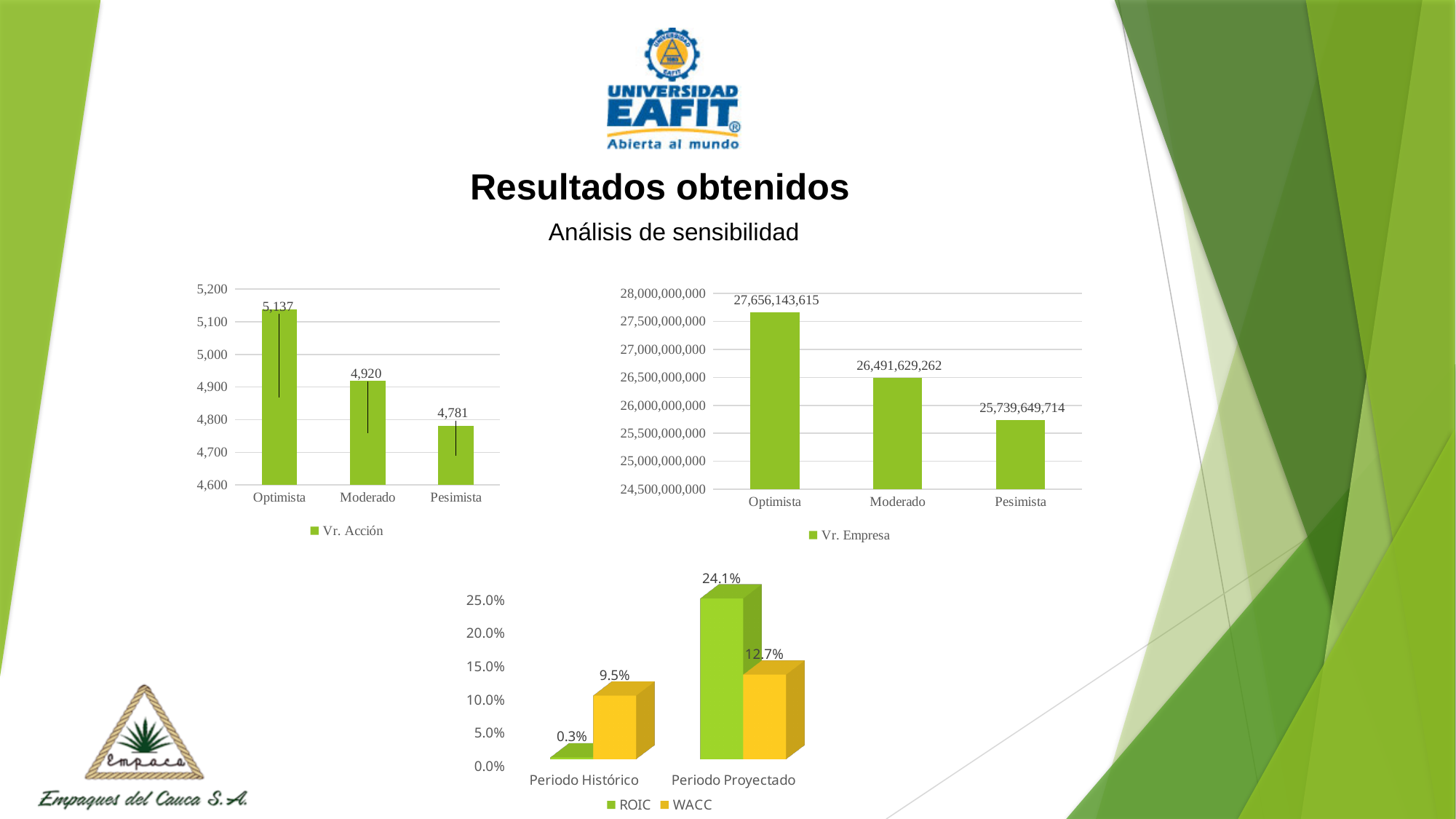
In the bottom chart (ROIC and WACC), what is the ROIC value for Periodo Proyectado? 24.1% In the top-right chart (Vr. Empresa), what is the value for Moderado? 26,491,629,262 In the top-right chart (Vr. Empresa), how many scenarios are shown on the x axis? 3 In the top-left chart (Vr. Acción), what is the value for Pesimista? 4,781 In the bottom chart (ROIC and WACC), which is larger for Periodo Histórico, ROIC or WACC? WACC In the top-left chart (Vr. Acción), which scenario has the lowest value? Pesimista In the top-left chart (Vr. Acción), what is the difference between the Optimista and Moderado values? 217 In the top-left chart (Vr. Acción), what is the value for Optimista? 5,137 In the top-right chart (Vr. Empresa), which scenario has the highest value? Optimista In the bottom chart (ROIC and WACC), what is the WACC value for Periodo Histórico? 9.5% In the bottom chart (ROIC and WACC), how many series does the legend list? 2 In the top-right chart (Vr. Empresa), is the value for Pesimista greater or less than 26,000,000,000? less